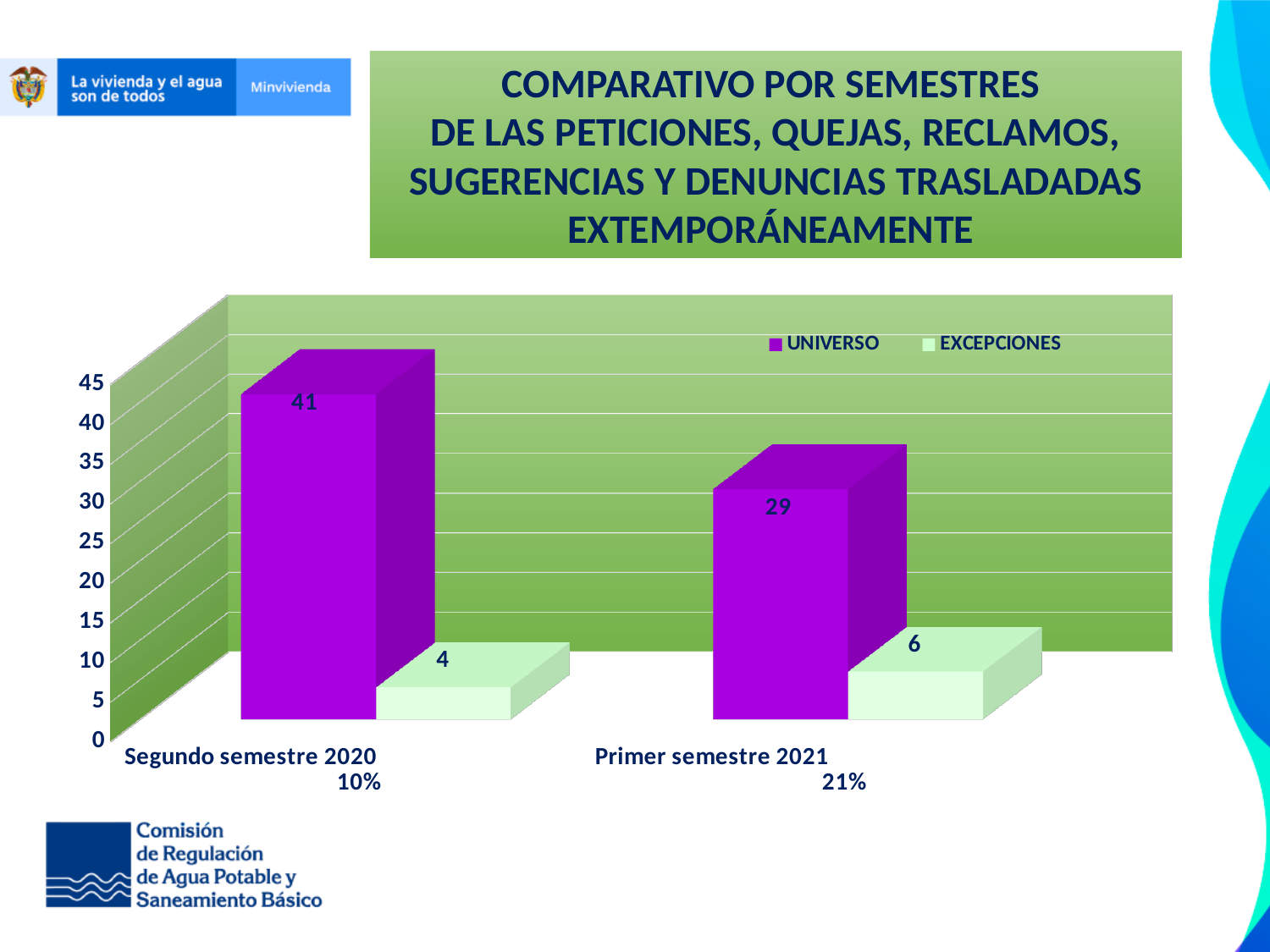
Is the EXCEPCIONES value for Primer semestre 2021 larger or smaller than the EXCEPCIONES value for Segundo semestre 2020? larger Which semester has the higher UNIVERSO value? Segundo semestre 2020 What is the difference between the UNIVERSO values for Segundo semestre 2020 and Primer semestre 2021? 12 How many semesters (categories) are shown on the x axis? 2 What is the EXCEPCIONES value for Primer semestre 2021? 6 What is the UNIVERSO value for Primer semestre 2021? 29 Which semester has the lower EXCEPCIONES value? Segundo semestre 2020 What kind of chart is shown on the slide? bar chart What is the UNIVERSO value for Segundo semestre 2020? 41 Which colour represents the UNIVERSO series in the legend? purple What is the EXCEPCIONES value for Segundo semestre 2020? 4 How many series does the legend list? 2